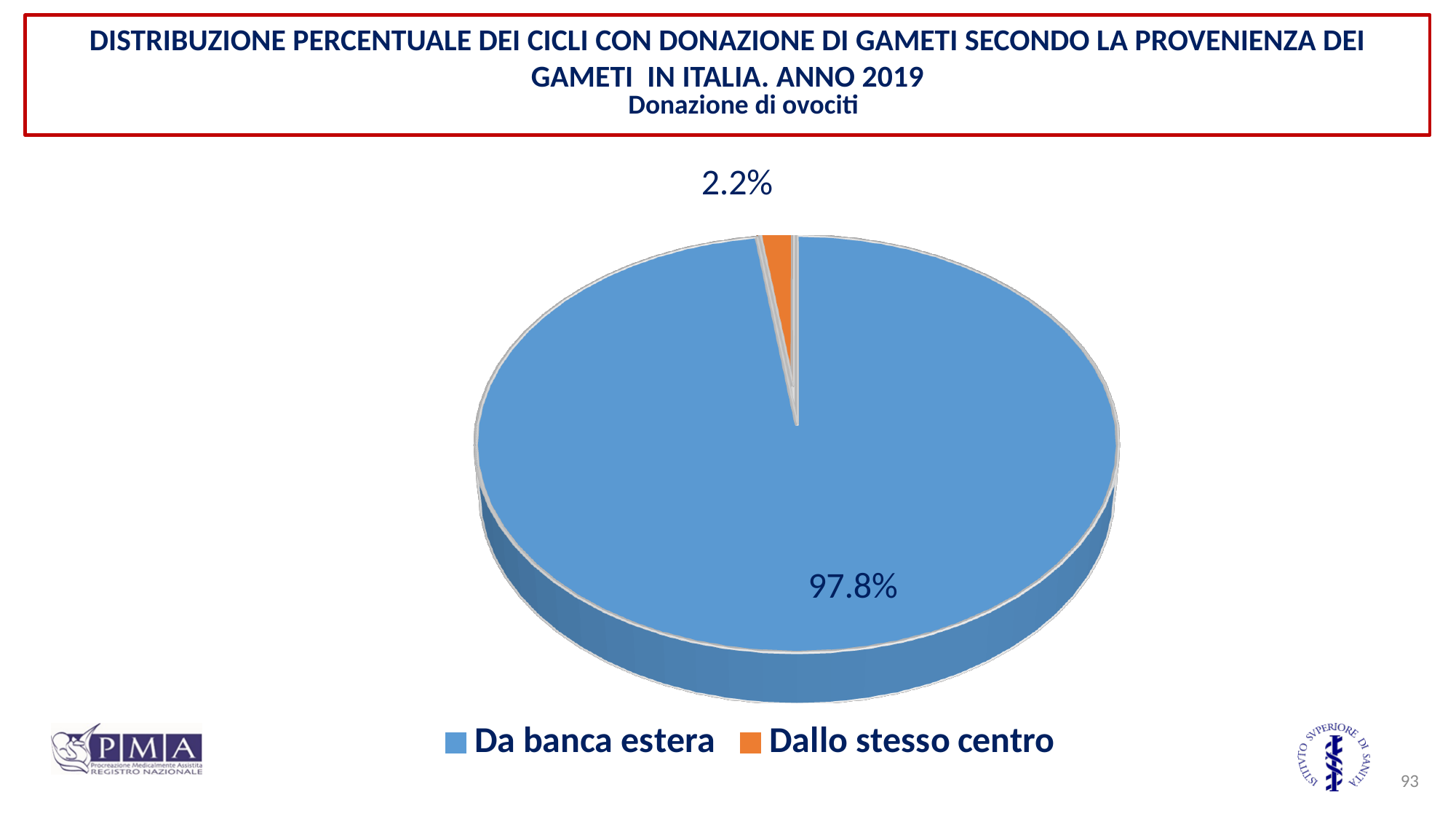
What is the share of the pie taken by 'Dallo stesso centro'? 2.2% Which is larger: the share for 'Da banca estera' or for 'Dallo stesso centro'? Da banca estera Which category has the largest share of the pie? Da banca estera Which category has the smallest share of the pie? Dallo stesso centro How many entries does the legend list? 2 How many categories are shown in the pie chart? 2 What percentage of oocyte donation cycles used gametes from the same centre (Dallo stesso centro)? 2.2% What percentage of oocyte donation cycles used gametes from a foreign bank (Da banca estera)? 97.8% What is the difference in percentage points between the 'Da banca estera' and 'Dallo stesso centro' shares? 95.6 What kind of chart is shown on the slide? Pie chart What colour represents 'Dallo stesso centro' in the chart? Orange What is the subtitle of the chart shown below the main title? Donazione di ovociti